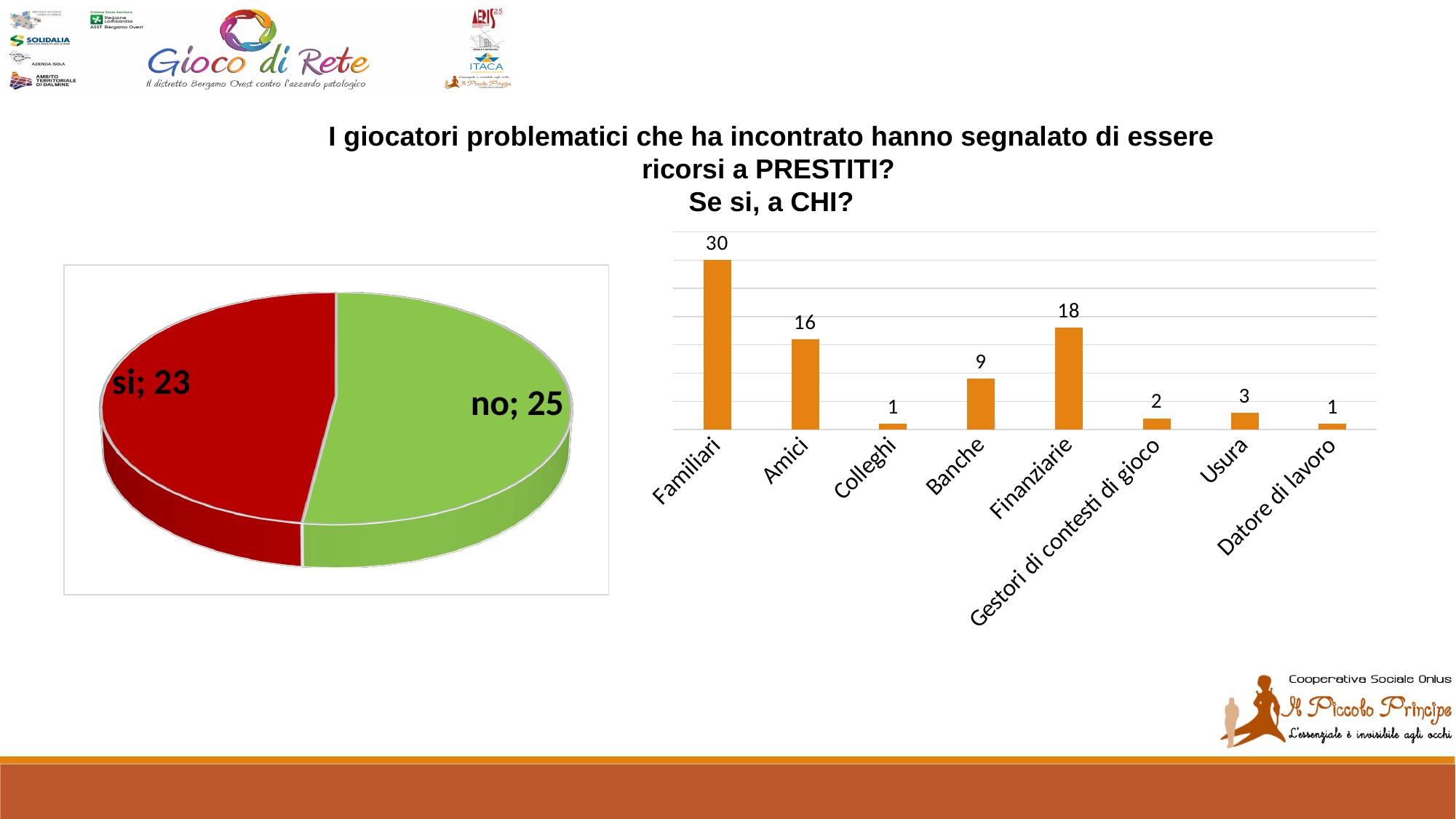
In the pie chart on the left, which slice is larger, "si" or "no"? no In the pie chart on the left, what is the value for "si"? 23 In the bar chart on the right, which is larger, Banche or Usura? Banche In the bar chart on the right, what is the difference between Familiari and Amici? 14 In the bar chart on the right, what is the value for Familiari? 30 What kind of chart is on the right side of the slide? Bar chart In the bar chart on the right, how many categories are shown? 8 In the bar chart on the right, what is the value for Finanziarie? 18 In the bar chart on the right, what is the value for Gestori di contesti di gioco? 2 In the pie chart on the left, what is the difference between the "no" and "si" values? 2 In the pie chart on the left, what is the value for "no"? 25 In the bar chart on the right, which category has the highest value? Familiari